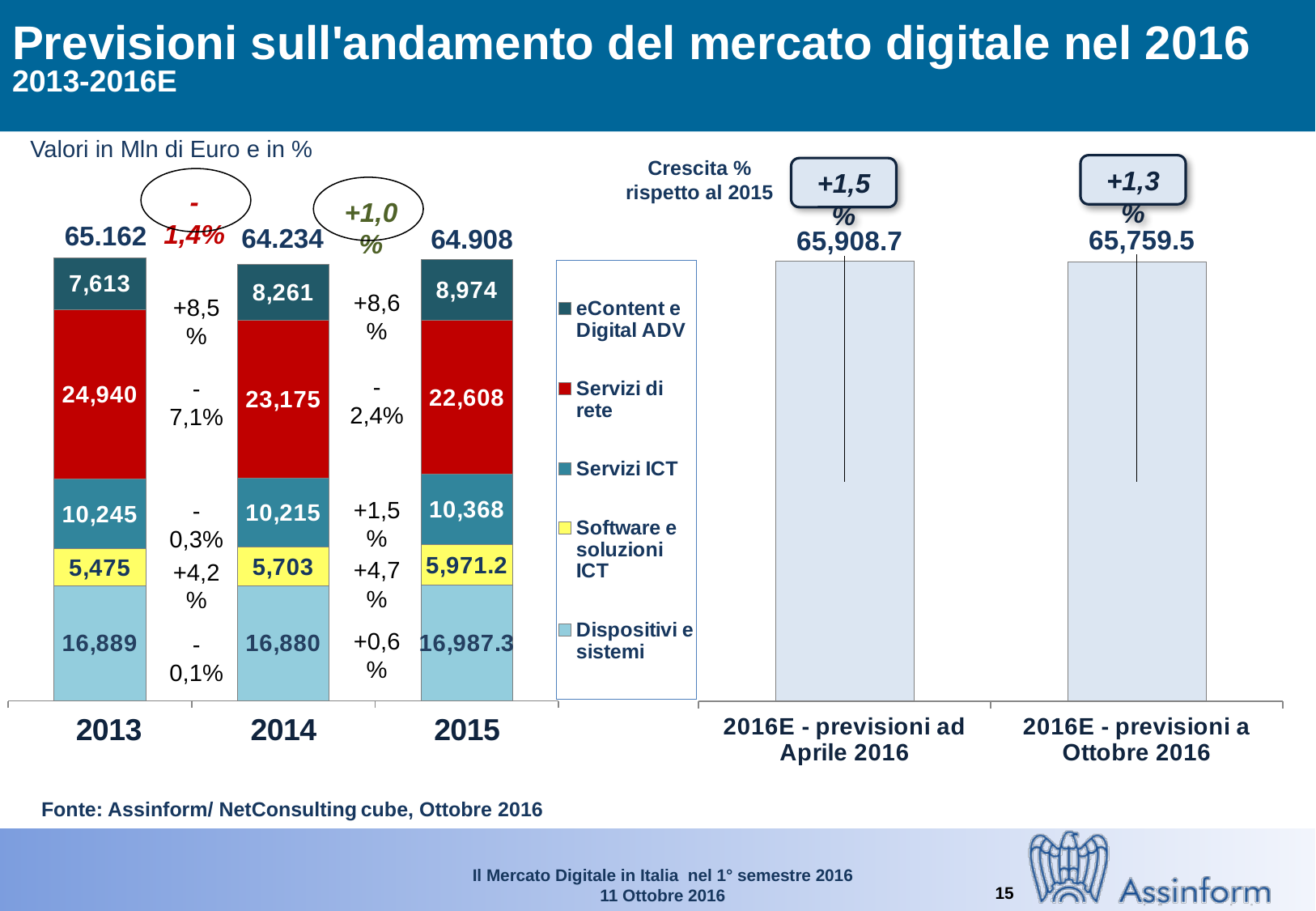
In the stacked bar chart, does the value of Servizi di rete rise or fall from 2013 to 2015? Fall How many years are shown on the x axis of the stacked bar chart? 3 In the stacked bar chart, what is the value of Dispositivi e sistemi in 2015? 16,987.3 In the right-hand chart, what is the difference between the Aprile 2016 forecast and the Ottobre 2016 forecast? 149.2 In the stacked bar chart, what is the value of Servizi di rete in 2014? 23,175 In the stacked bar chart, which segment is the smallest in the 2015 bar? Software e soluzioni ICT In the right-hand chart, what is the value for 2016E - previsioni a Ottobre 2016? 65,759.5 What kind of chart is used for the 2013-2015 data? Stacked bar chart In the right-hand chart, which forecast for 2016E is higher: previsioni ad Aprile 2016 or previsioni a Ottobre 2016? 2016E - previsioni ad Aprile 2016 In the stacked bar chart, which segment is the largest in the 2013 bar? Servizi di rete How many series does the legend of the stacked bar chart list? 5 In the stacked bar chart, by how much did eContent e Digital ADV increase from 2013 to 2015? 1,361